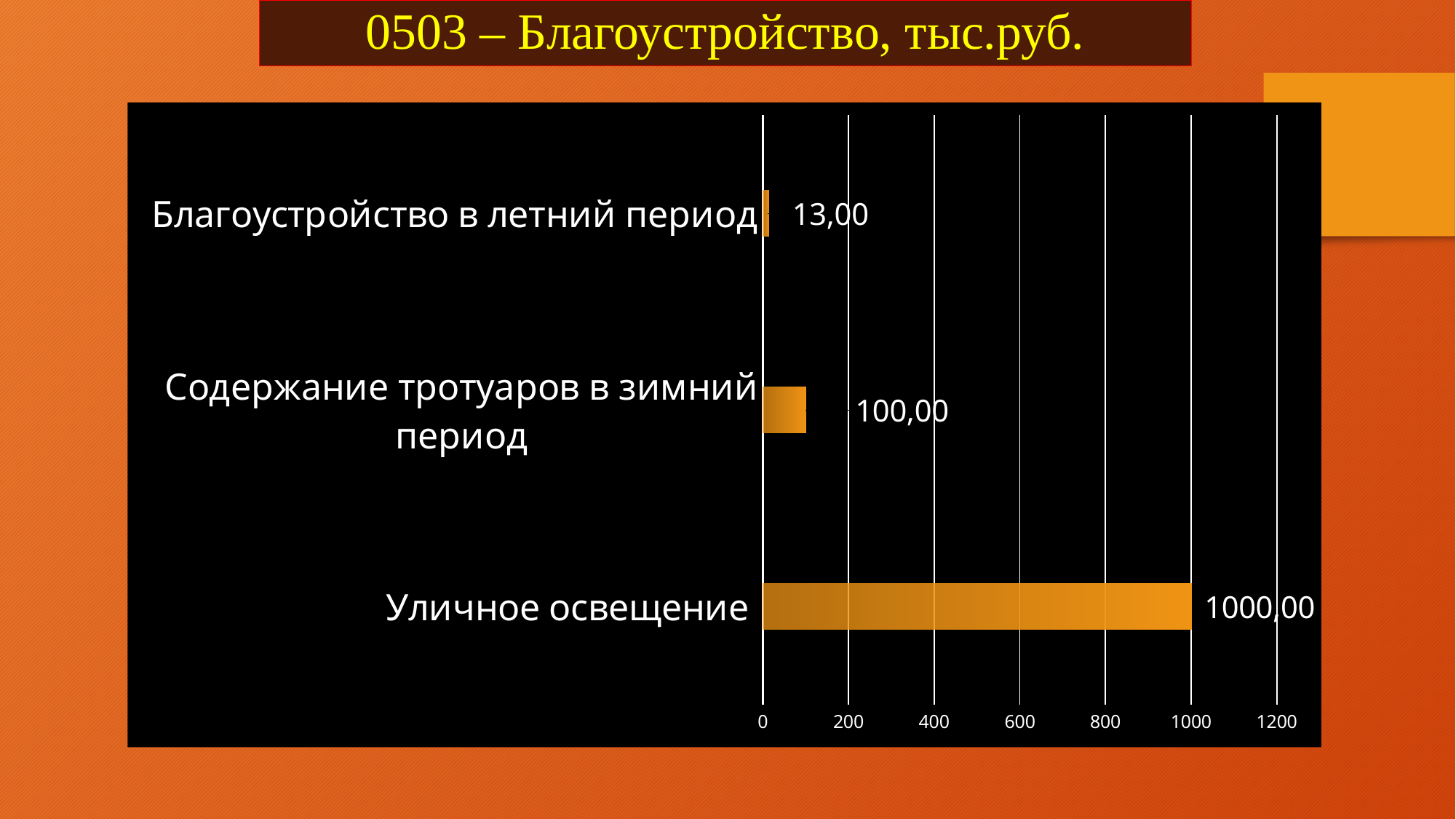
Which is larger: the value for Содержание тротуаров в зимний период or the value for Благоустройство в летний период? Содержание тротуаров в зимний период What is the difference between the values for Уличное освещение and Содержание тротуаров в зимний период? 900,00 What is the difference between the values for Содержание тротуаров в зимний период and Благоустройство в летний период? 87,00 What is the value for Благоустройство в летний период? 13,00 What is the title of the slide? 0503 – Благоустройство, тыс.руб. What kind of chart is shown on the slide? bar chart Which category has the lowest value? Благоустройство в летний период Is the value for Уличное освещение greater or less than 800? greater What is the value for Уличное освещение? 1000,00 Which category has the highest value? Уличное освещение How many categories are shown in the chart? 3 What is the value for Содержание тротуаров в зимний период? 100,00